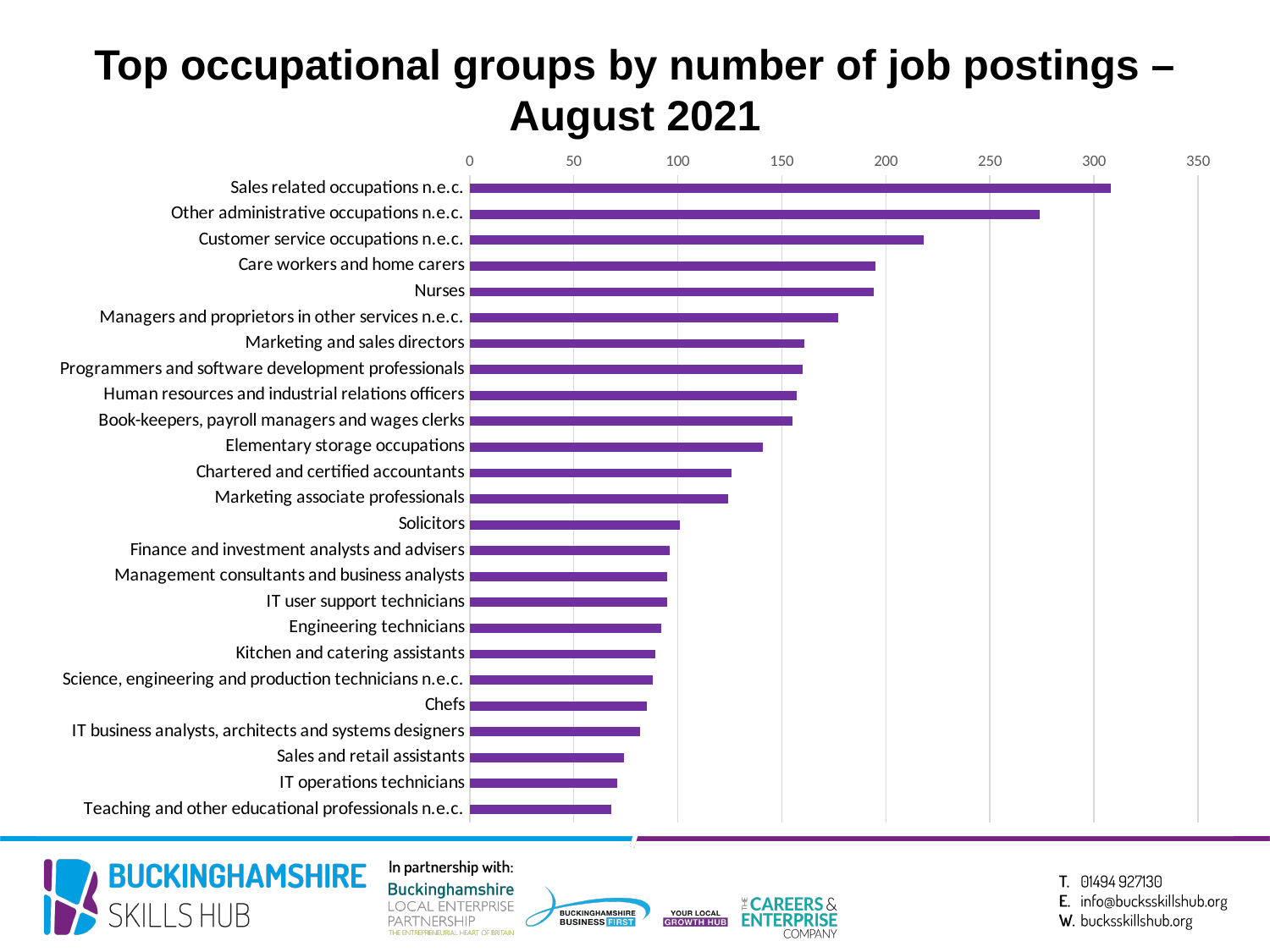
Is the value for Other administrative occupations n.e.c. greater or less than 250? greater Is the value for Elementary storage occupations greater or less than 150? less What is the title of the chart? Top occupational groups by number of job postings – August 2021 Is the value for Chefs greater or less than 100? less Which occupational group has the highest number of job postings? Sales related occupations n.e.c. Which occupational group has the lowest number of job postings? Teaching and other educational professionals n.e.c. Which has more job postings: Solicitors or Chefs? Solicitors How many occupational groups are shown in the chart? 25 What kind of chart is shown on the slide? bar chart Which has more job postings: Customer service occupations n.e.c. or Nurses? Customer service occupations n.e.c.